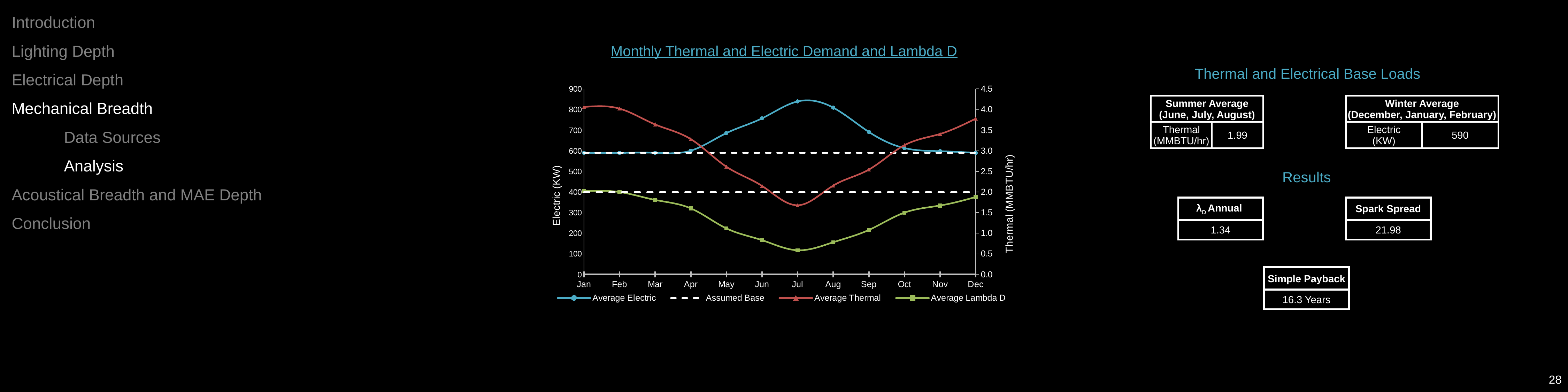
What is the title of the chart? Monthly Thermal and Electric Demand and Lambda D In which month does the Average Thermal series reach its lowest value? Jul In which month does the Average Electric series reach its highest value? Jul Does the Average Electric series rise or fall from Apr to Jul? rise Which is larger, the Average Thermal value for Jan or for Jul? Jan Is the Average Thermal value for Jul greater or less than 2.0? less In which month does the Average Lambda D series reach its lowest value? Jul Is the Average Electric value for Jul greater or less than 800? greater How many months are plotted along the x axis of the chart? 12 Is the Average Lambda D value for Jul greater or less than 1.0? less How many series does the chart legend list? 4 What kind of chart is shown on the slide? line chart